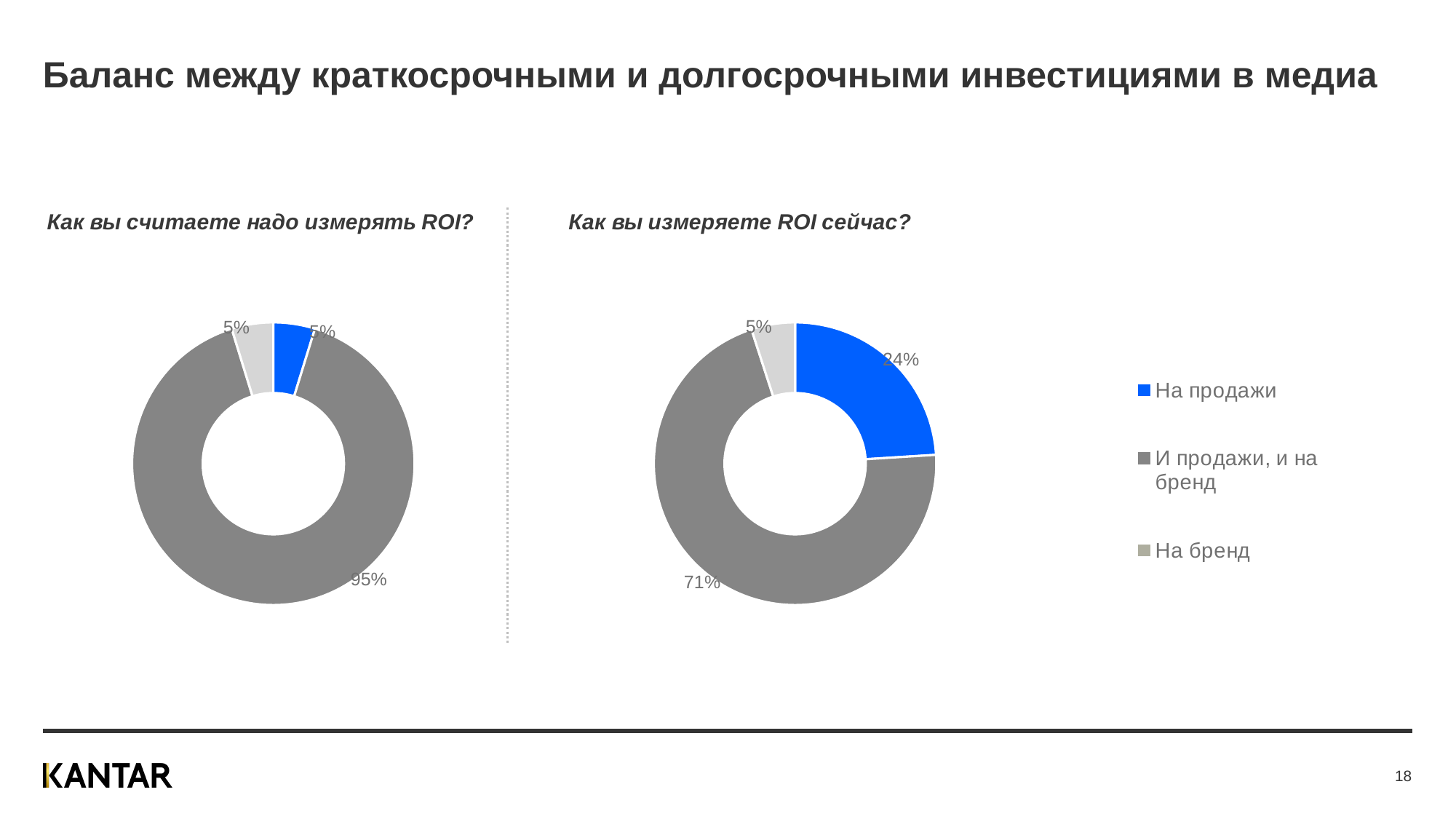
In the chart titled "Как вы считаете надо измерять ROI?", which category has the largest share? И продажи, и на бренд In the chart titled "Как вы считаете надо измерять ROI?", what share is labelled for "И продажи, и на бренд"? 95% In the chart titled "Как вы измеряете ROI сейчас?", what share is labelled for "На продажи"? 24% In the chart titled "Как вы измеряете ROI сейчас?", which category has the smallest share? На бренд Which colour represents "На продажи" in the legend? Blue What type of chart is used on this slide? Pie (donut) chart How many charts are shown on the slide? 2 How many categories does the legend list? 3 Which chart shows a larger share for "На продажи": "Как вы считаете надо измерять ROI?" or "Как вы измеряете ROI сейчас?"? Как вы измеряете ROI сейчас? In the chart titled "Как вы измеряете ROI сейчас?", what is the difference between the shares for "И продажи, и на бренд" and "На продажи"? 47 percentage points In the chart titled "Как вы измеряете ROI сейчас?", what share is labelled for "На бренд"? 5% In the chart titled "Как вы измеряете ROI сейчас?", what share is labelled for "И продажи, и на бренд"? 71%